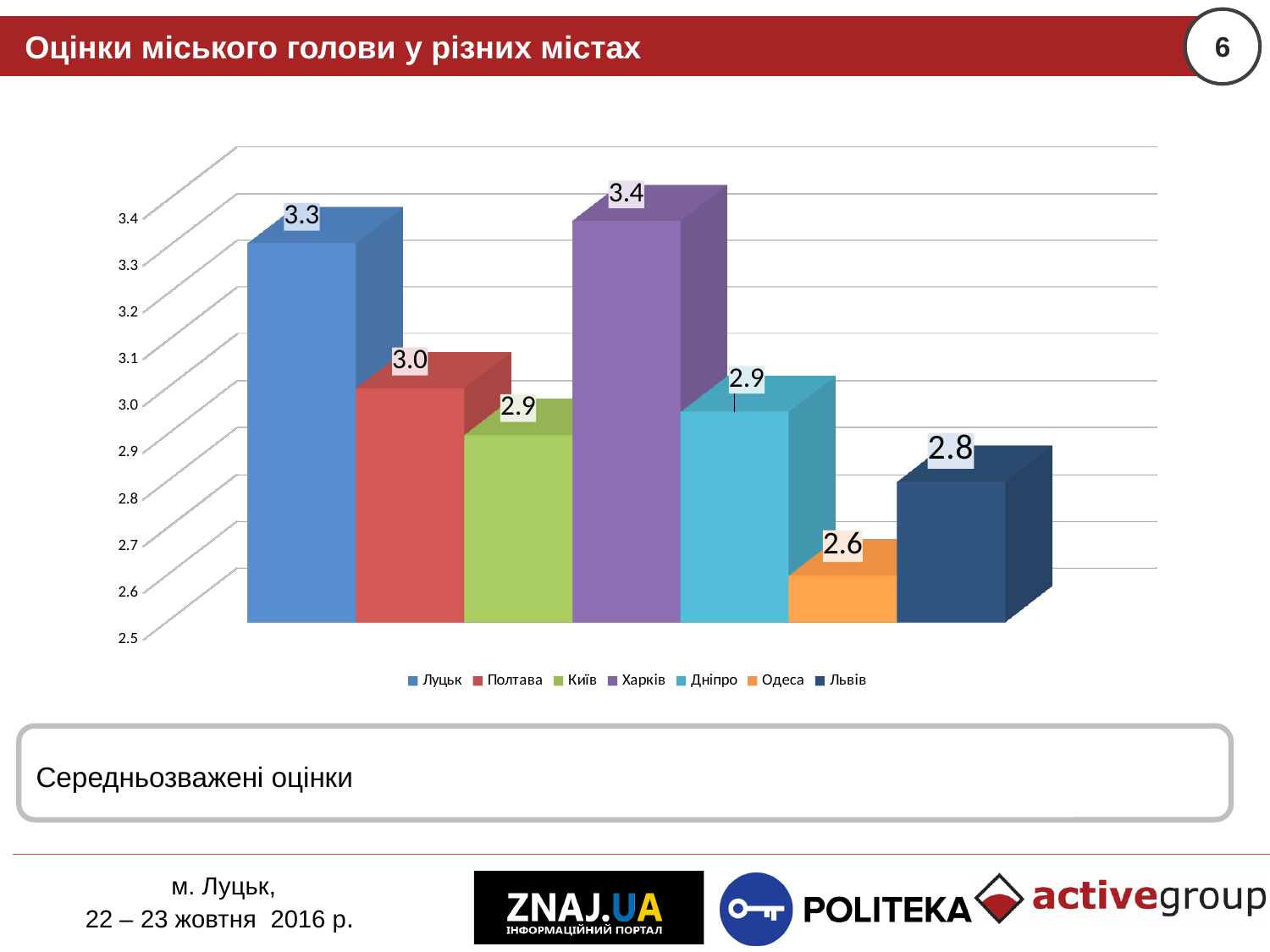
Which city has the lowest value? Одеса What is the value for Луцьк? 3.3 What is the difference between the values for Луцьк and Полтава? 0.3 How many cities are shown in the chart? 7 What is the difference between the values for Харків and Одеса? 0.8 What is the value for Одеса? 2.6 What is the value for Львів? 2.8 Which is larger, the value for Полтава or the value for Львів? Полтава What is the title of the slide? Оцінки міського голови у різних містах What kind of chart is shown on the slide? bar chart Which city has the highest value? Харків What is the value for Харків? 3.4